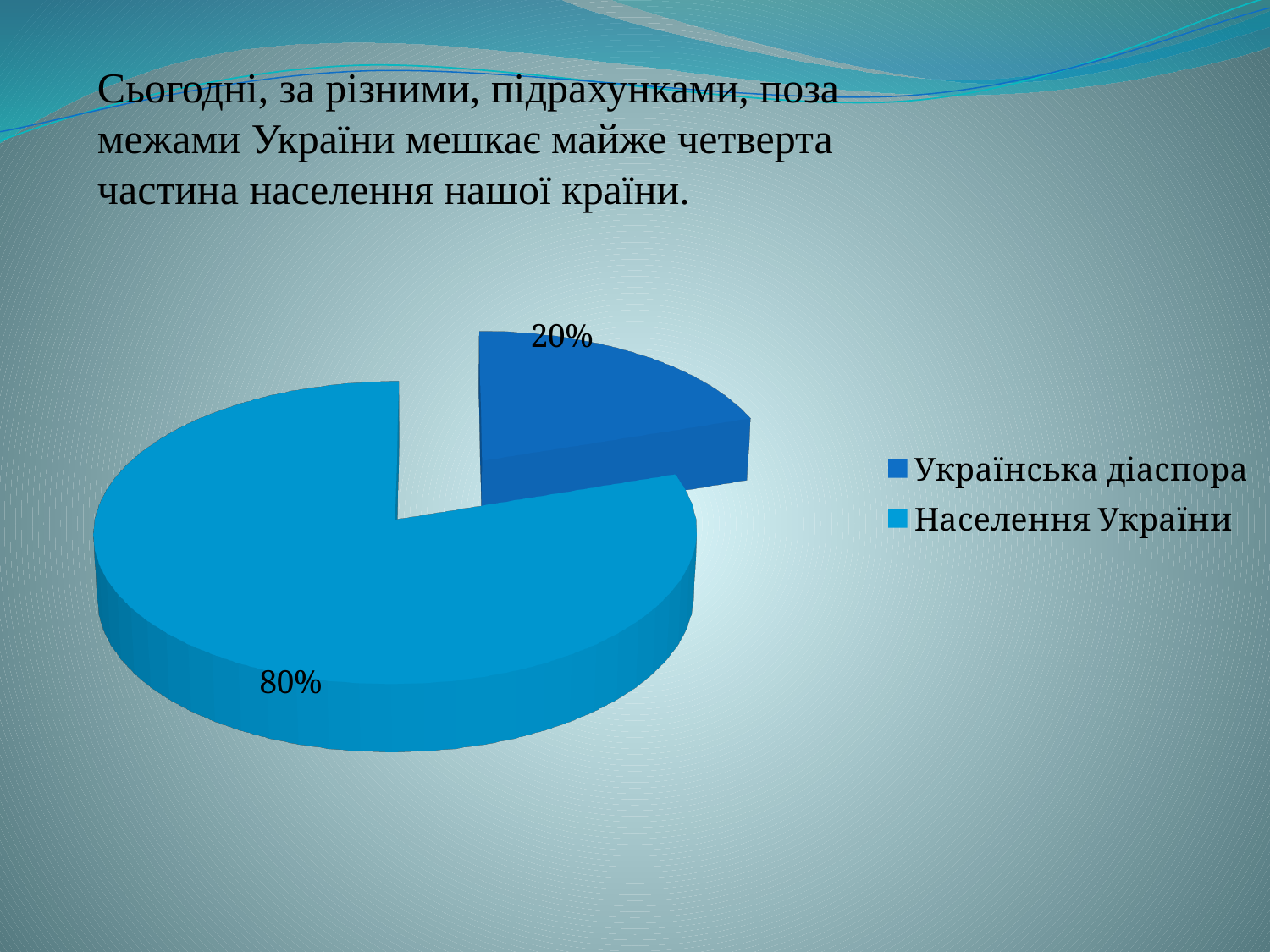
How many entries does the legend list? 2 Which slice is pulled out (exploded) from the rest of the pie? Українська діаспора What is the difference in percentage points between the "Населення України" slice and the "Українська діаспора" slice? 60 percentage points What share of the pie does "Населення України" represent? 80% How many slices does the pie chart have? 2 Which slice of the pie is the smallest? Українська діаспора What share of the pie does "Українська діаспора" represent? 20% Which legend entry is shown in the darker blue colour? Українська діаспора What kind of chart is shown on the slide? pie chart Which slice of the pie is the largest? Населення України Which is larger: the share for "Українська діаспора" or the share for "Населення України"? Населення України Is the share for "Українська діаспора" greater or less than 50%? less